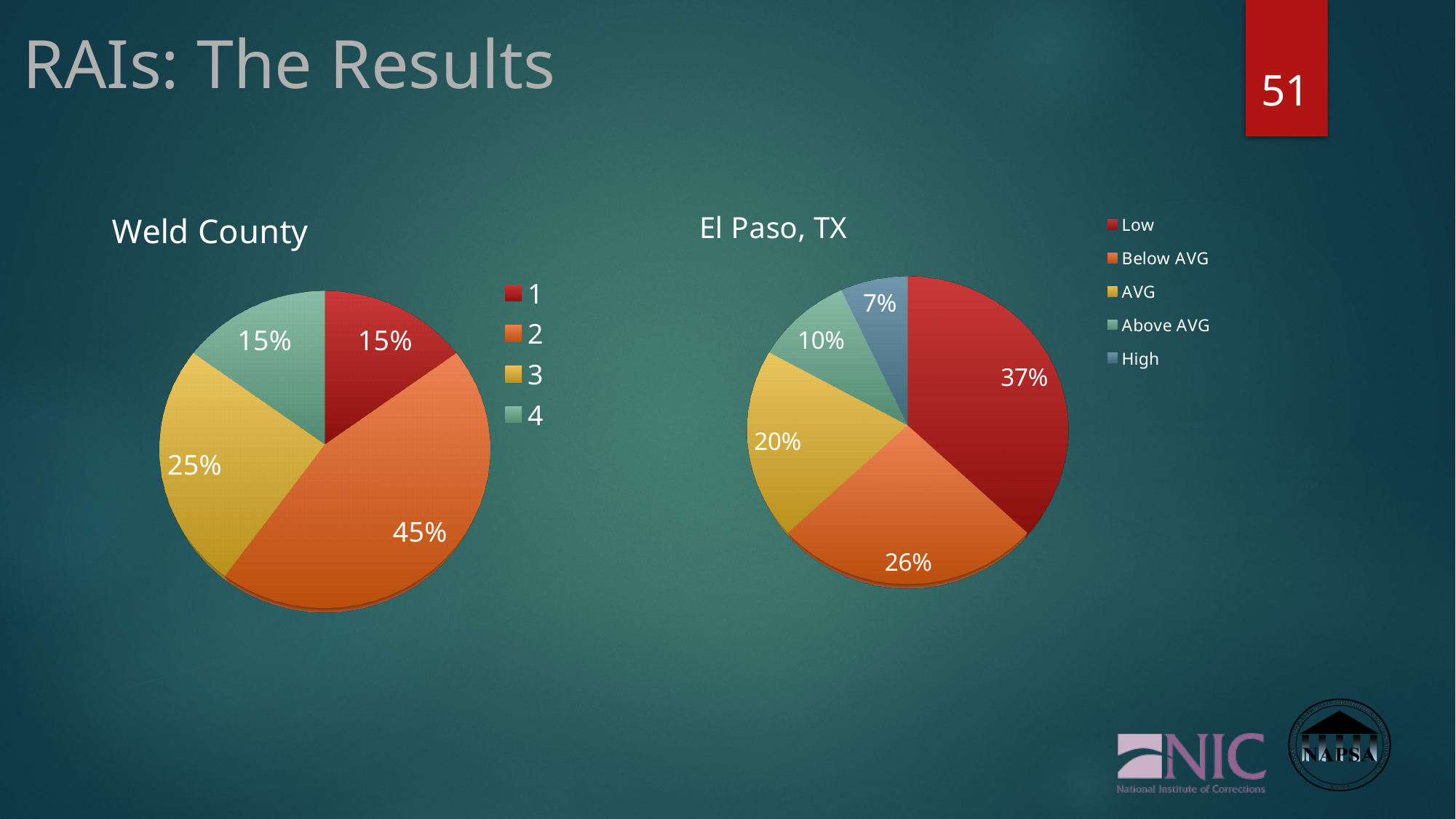
In the Weld County chart, how many categories does the legend list? 4 In the El Paso, TX chart, which is larger, Below AVG or AVG? Below AVG In the Weld County chart, what share does category 3 have? 25% In the Weld County chart, what share does category 2 have? 45% In the Weld County chart, which category has the largest share? 2 What kind of chart is the El Paso, TX chart? Pie chart In the El Paso, TX chart, what is the difference between the shares of Low and Below AVG? 11% In the El Paso, TX chart, what share does Above AVG have? 10% In the El Paso, TX chart, how many categories does the legend list? 5 In the Weld County chart, what is the difference between the shares of category 2 and category 3? 20% In the El Paso, TX chart, what share does Low have? 37% In the El Paso, TX chart, which category has the smallest share? High